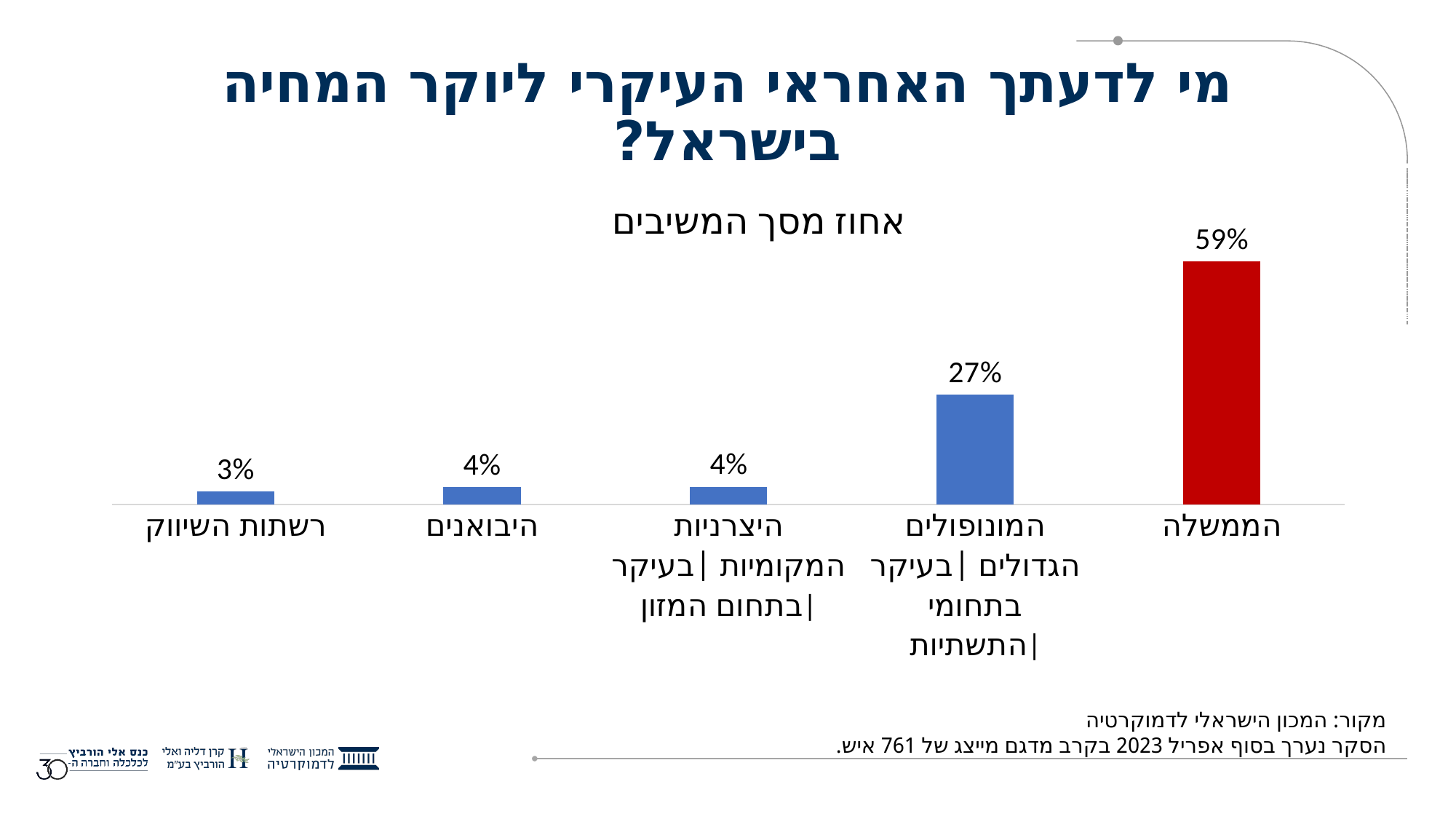
What percentage of respondents chose הממשלה as mainly responsible for the cost of living? 59% Which is larger, the value for המונופולים הגדולים or the value for היבואנים? המונופולים הגדולים How many categories are shown in the chart? 5 What kind of chart is shown on the slide? Bar chart Which category has the lowest value in the chart? רשתות השיווק Which bar is coloured red rather than blue? הממשלה What is the difference between the values for הממשלה and המונופולים הגדולים? 32% What value is shown for רשתות השיווק? 3% What value is shown for המונופולים הגדולים? 27% Which category has the highest value in the chart? הממשלה What is the subtitle shown above the chart? אחוז מסך המשיבים What value is shown for היבואנים? 4%